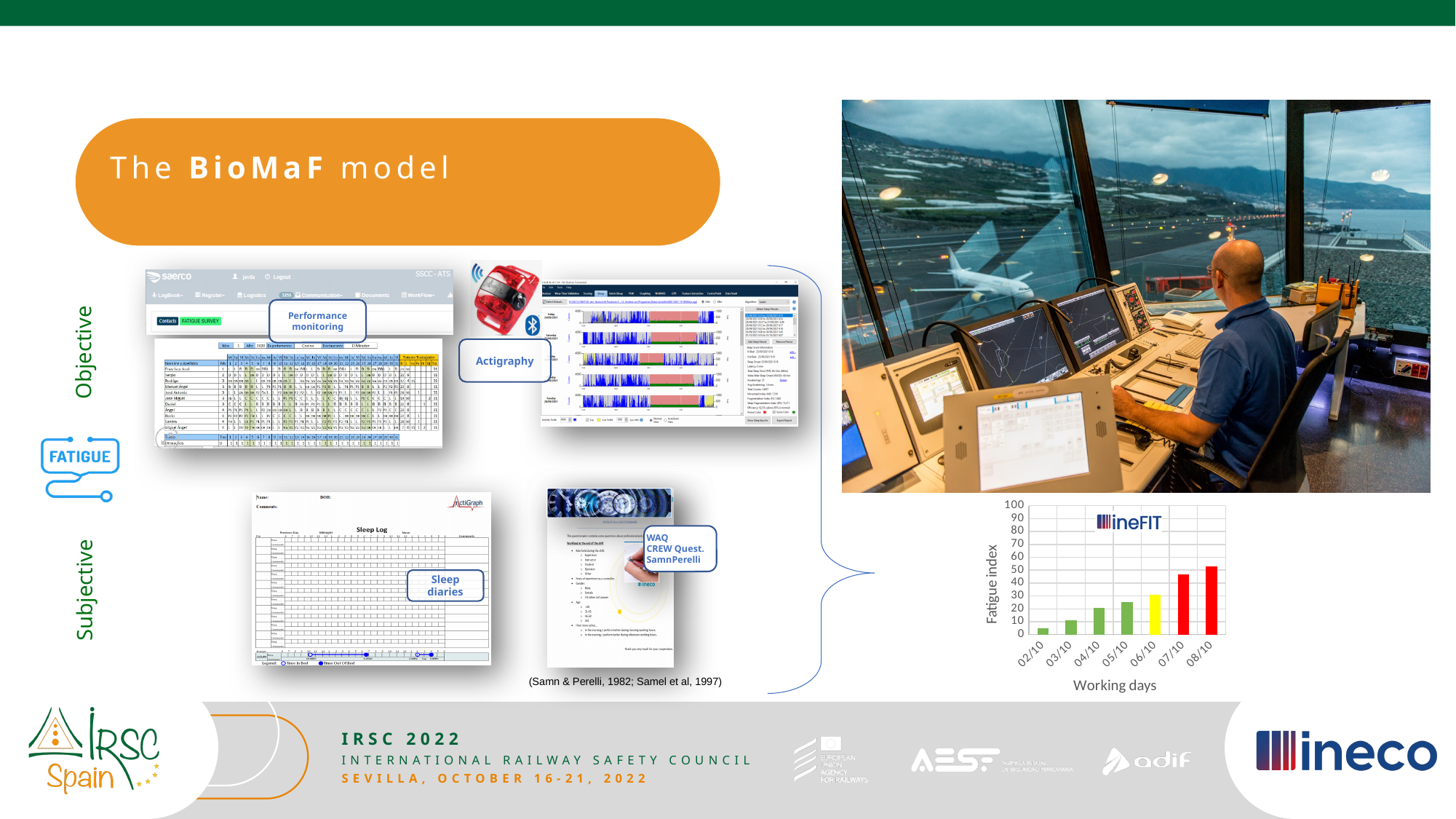
Is the fatigue index for 06/10 greater or less than 20? greater How many working days are plotted on the Fatigue index chart? 7 Is the fatigue index for 04/10 greater or less than 30? less What kind of chart is shown at the bottom right of the slide? bar chart Which working day has the lowest fatigue index on the chart? 02/10 Is the fatigue index for 02/10 greater or less than 10? less Which has a higher fatigue index, 07/10 or 05/10? 07/10 Does the fatigue index rise or fall from 02/10 to 08/10? rise Which working day has the highest fatigue index on the chart? 08/10 What is the label of the vertical axis on the bar chart? Fatigue index What colour are the bars for 07/10 and 08/10 on the chart? red